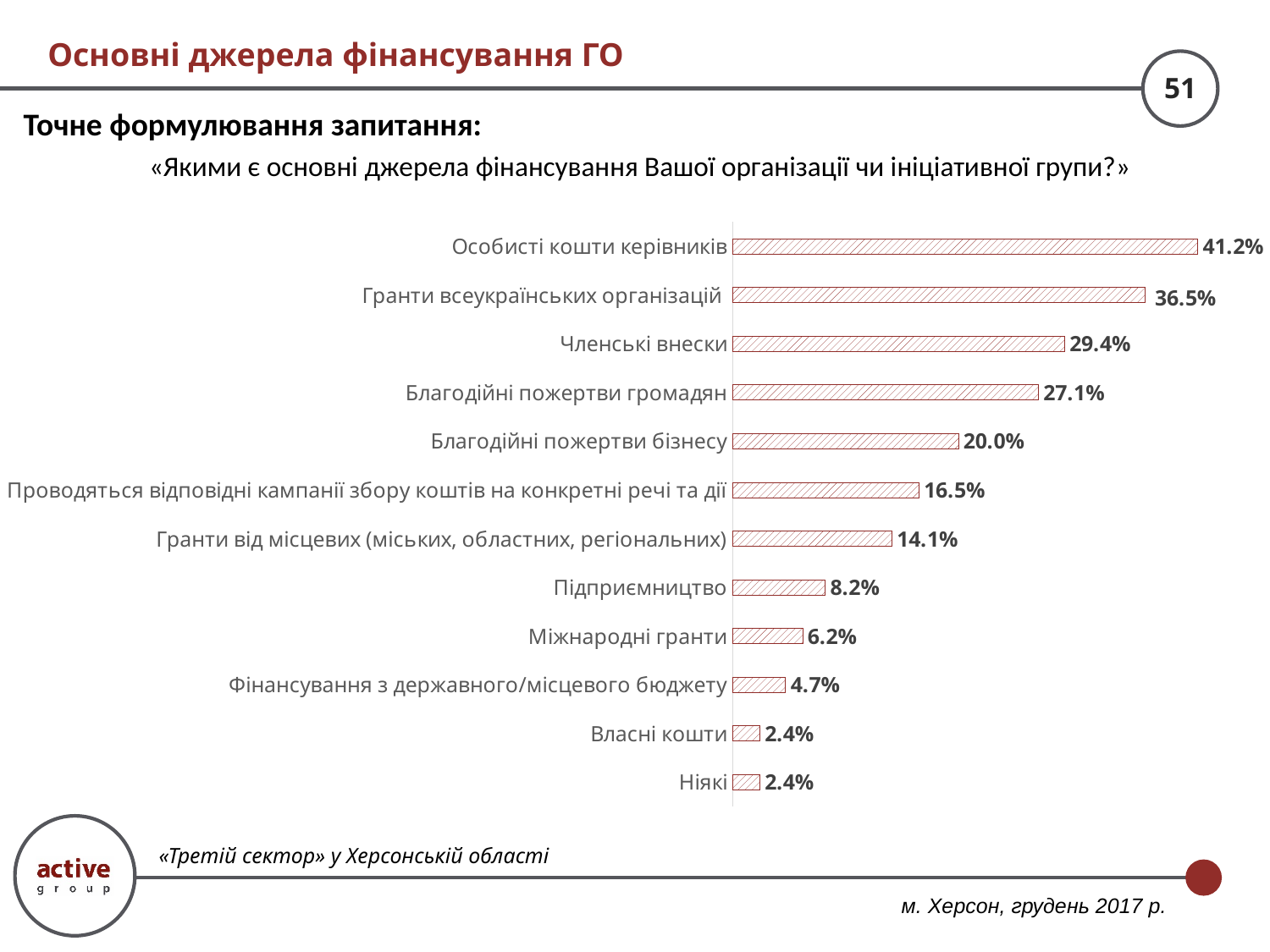
What kind of chart is shown on the slide? Bar chart What is the difference between «Особисті кошти керівників» and «Благодійні пожертви громадян»? 14.1% What is the difference between «Гранти всеукраїнських організацій» and «Членські внески»? 7.1% What is the value for «Міжнародні гранти»? 6.2% What is the value for «Проводяться відповідні кампанії збору коштів на конкретні речі та дії»? 16.5% Which category has the highest value? Особисті кошти керівників What is the value for «Особисті кошти керівників»? 41.2% What is the value for «Благодійні пожертви бізнесу»? 20.0% Which is larger: «Благодійні пожертви громадян» or «Гранти від місцевих (міських, обласних, регіональних)»? Благодійні пожертви громадян Which is larger: «Підприємництво» or «Фінансування з державного/місцевого бюджету»? Підприємництво What is the value for «Ніякі»? 2.4% How many categories are shown in the chart? 12